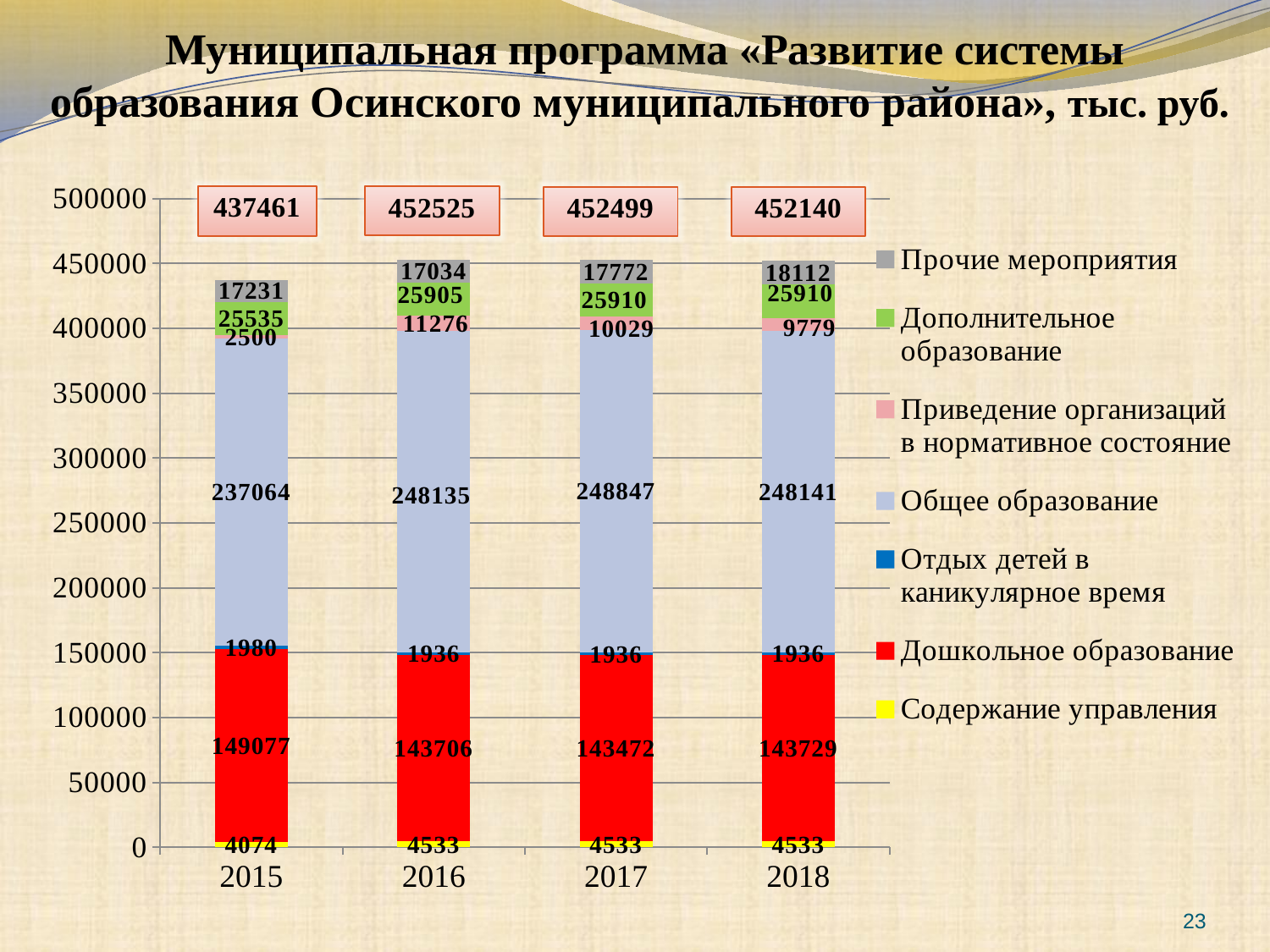
What is the difference between the Дошкольное образование values for 2015 and 2016? 5371 What is the value for Дошкольное образование in 2015? 149077 What is the value for Общее образование in 2017? 248847 What is the value for Приведение организаций в нормативное состояние in 2016? 11276 Which is larger: Дополнительное образование in 2015 or in 2016? 2016 What is the value for Прочие мероприятия in 2018? 18112 What kind of chart is shown on the slide? stacked bar chart Is the total for 2017 greater or less than 450000? greater How many series does the legend list? 7 Which year has the lowest total? 2015 How many years are shown on the x axis? 4 What is the total of the stacked bar for 2016? 452525